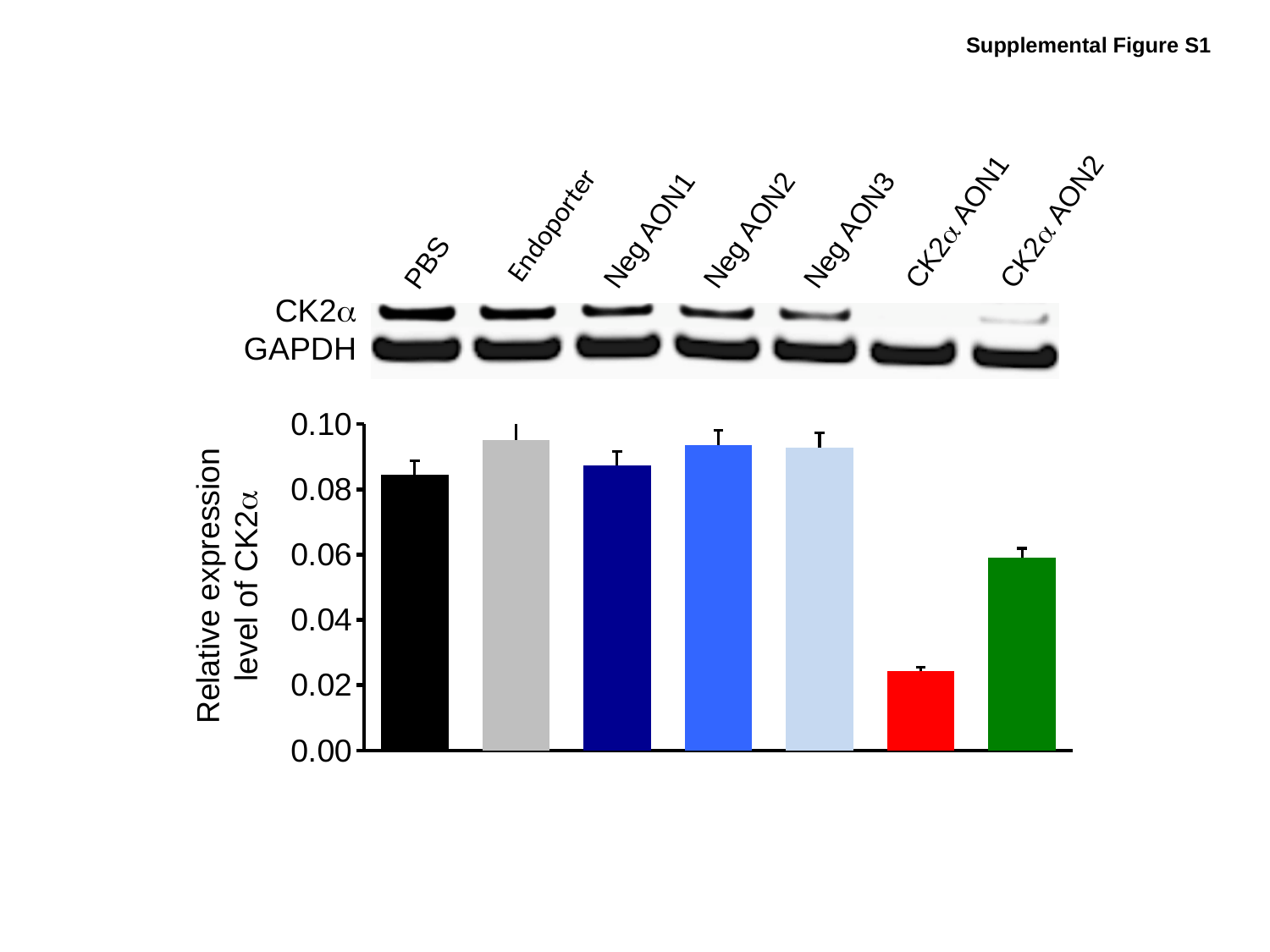
What kind of chart is shown on the slide? bar chart Which category has the lowest relative expression level of CK2α? CK2α AON1 Is the value for CK2α AON1 greater or less than 0.04? less What is the label of the y axis? Relative expression level of CK2α What colour is the bar for CK2α AON1? red Which is larger, the value for CK2α AON1 or CK2α AON2? CK2α AON2 Which is larger, the value for PBS or CK2α AON2? PBS How many bars are plotted in the chart? 7 Is the value for Endoporter greater or less than 0.10? less Is the value for CK2α AON2 greater or less than 0.04? greater